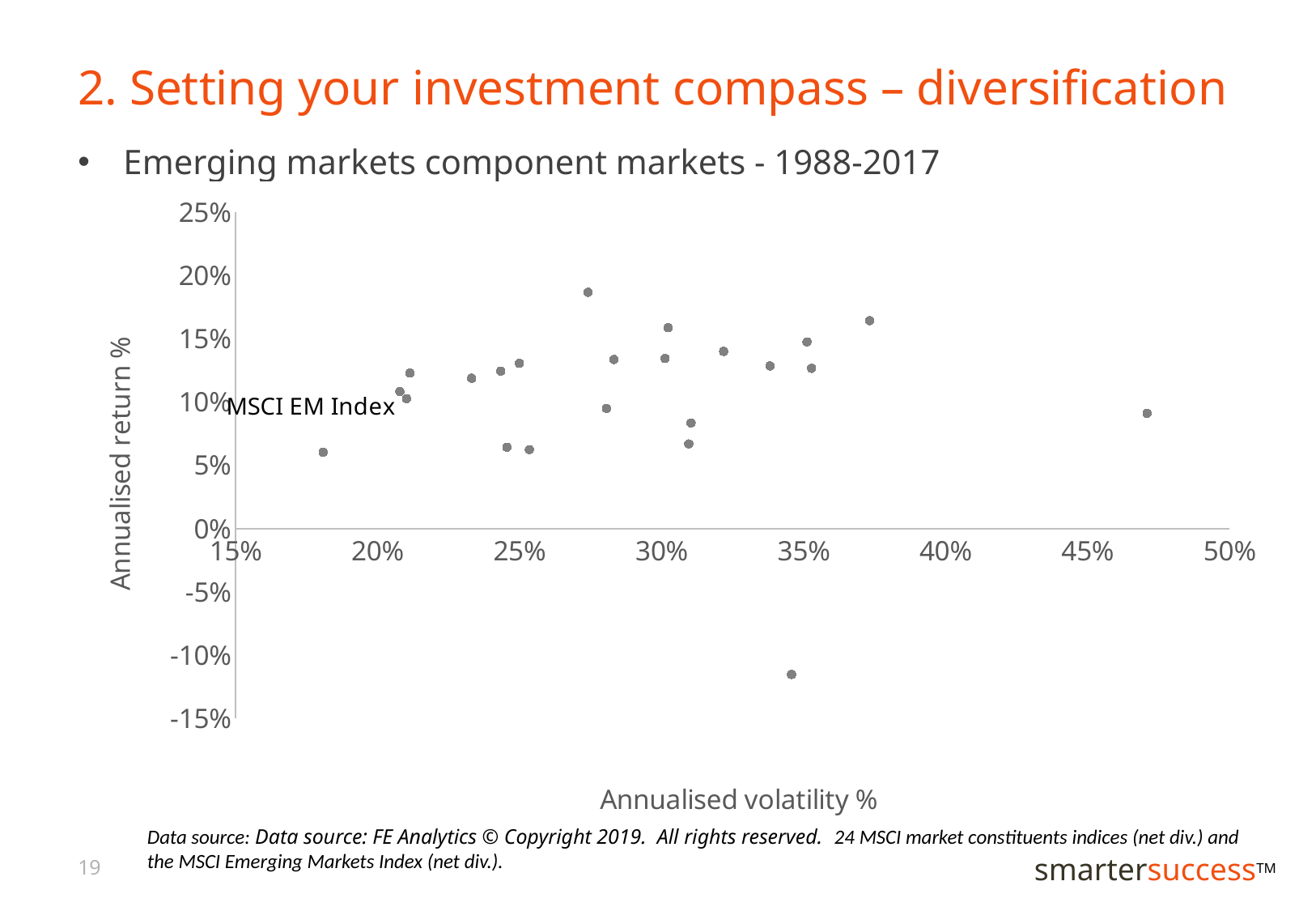
What is the maximum value shown on the horizontal axis? 50% Which data point on the chart is labelled by name? MSCI EM Index What kind of chart is shown on the slide? Scatter chart Is the annualised return of the lowest point on the chart greater or less than -10%? less Is the annualised return of the highest point on the chart greater or less than 15%? greater What is the title of the vertical axis of the chart? Annualised return % Is the annualised volatility of the rightmost point on the chart greater or less than 45%? greater What is the title of the horizontal axis of the chart? Annualised volatility %